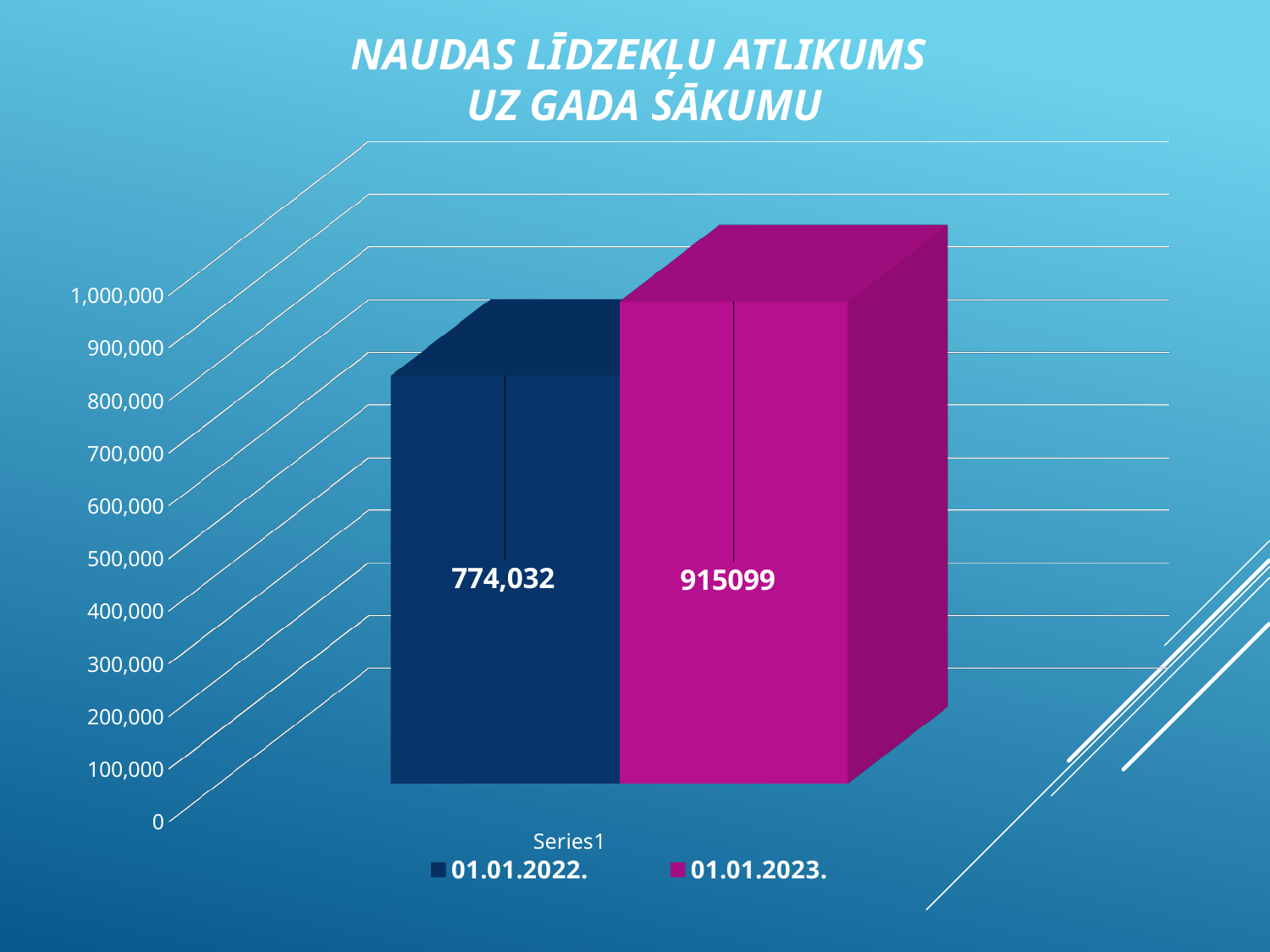
Which date has the higher value, 01.01.2022. or 01.01.2023.? 01.01.2023. Is the value for 01.01.2023. greater or less than 900,000? greater Which series has the highest value in the chart? 01.01.2023. What is the difference between the values for 01.01.2023. and 01.01.2022.? 141,067 What is the value shown for 01.01.2023.? 915099 What is the value shown for 01.01.2022.? 774,032 Is the value for 01.01.2022. greater or less than 800,000? less What kind of chart is shown on the slide? bar chart Which series has the lowest value in the chart? 01.01.2022. What colour is the bar for 01.01.2023.? magenta How many series does the legend list? 2 What is the title of the chart? NAUDAS LĪDZEKĻU ATLIKUMS UZ GADA SĀKUMU